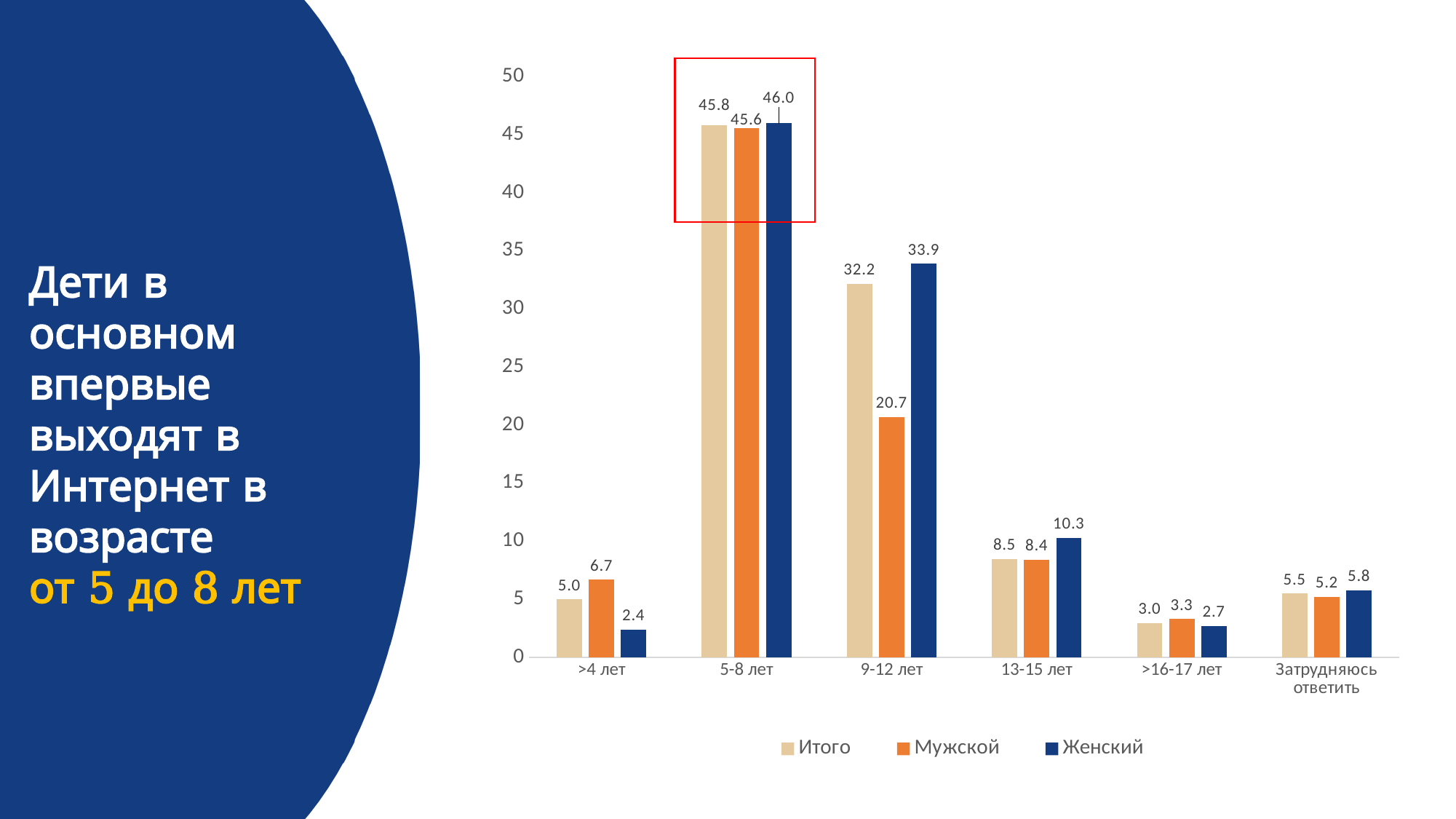
How many categories are shown on the x axis? 6 How many series does the legend list? 3 What is the difference between the Женский and Мужской values in the 9-12 лет category? 13.2 Which category has the highest value for the Женский series? 5-8 лет What is the value for Мужской in the 9-12 лет category? 20.7 In the >4 лет category, which is larger: the Мужской value or the Женский value? Мужской What is the value for Женский in the 13-15 лет category? 10.3 What kind of chart is shown on the slide? Bar chart What is the value for Итого in the Затрудняюсь ответить category? 5.5 Which series is shown in orange in the legend? Мужской Which category has the lowest value for the Итого series? >16-17 лет What is the value for Итого in the 5-8 лет category? 45.8